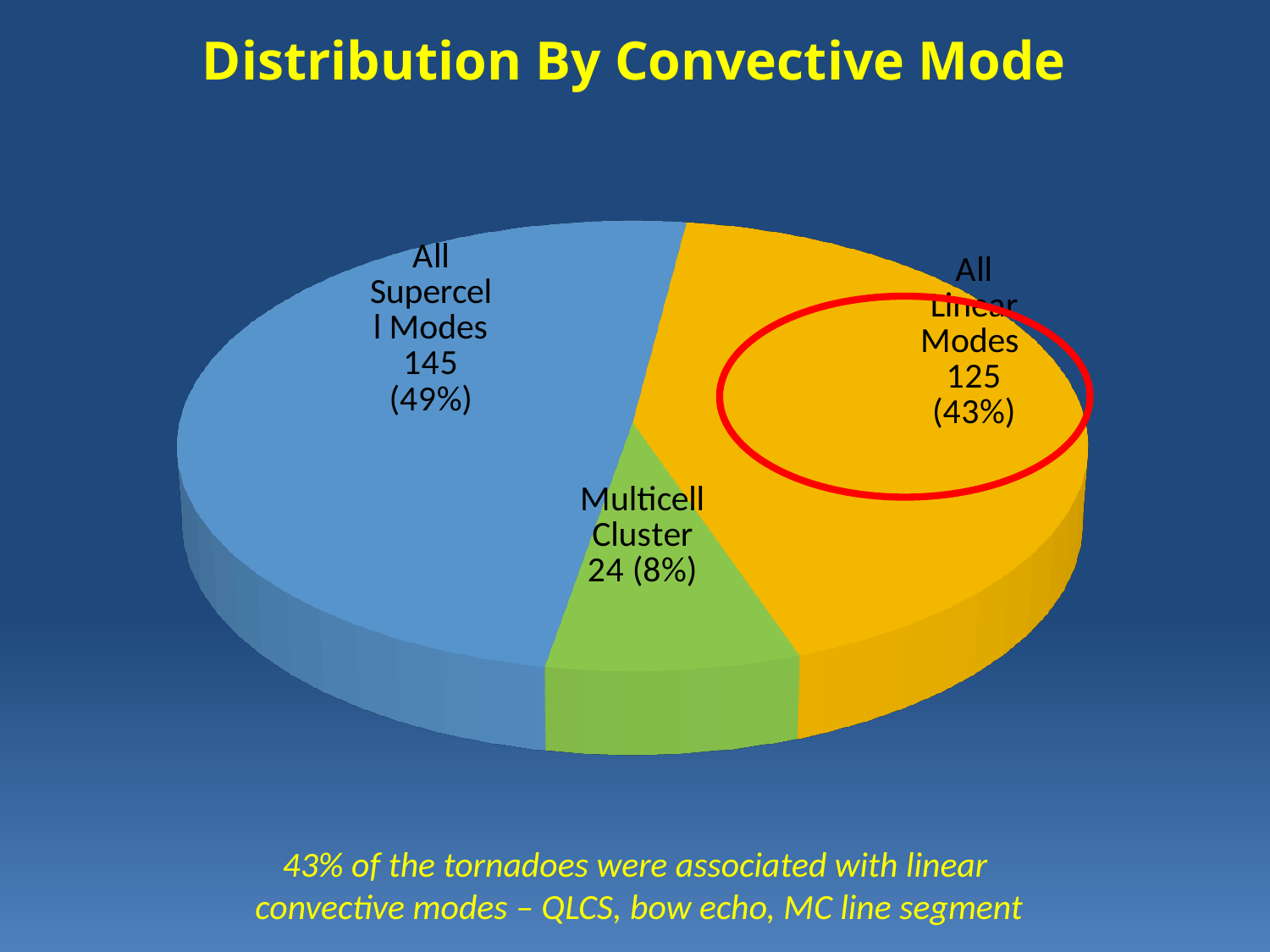
How many slices does the pie chart have? 3 Which category has the smallest slice? Multicell Cluster What is the count for Multicell Cluster? 24 What kind of chart is shown on the slide? pie chart What is the title of the chart? Distribution By Convective Mode Which is larger, the count for All Linear Modes or Multicell Cluster? All Linear Modes What percentage share does All Linear Modes have? 43% What is the difference in count between All Supercell Modes and All Linear Modes? 20 Which category has the largest slice? All Supercell Modes What is the count for All Supercell Modes? 145 What percentage share does Multicell Cluster have? 8% What is the count for All Linear Modes? 125